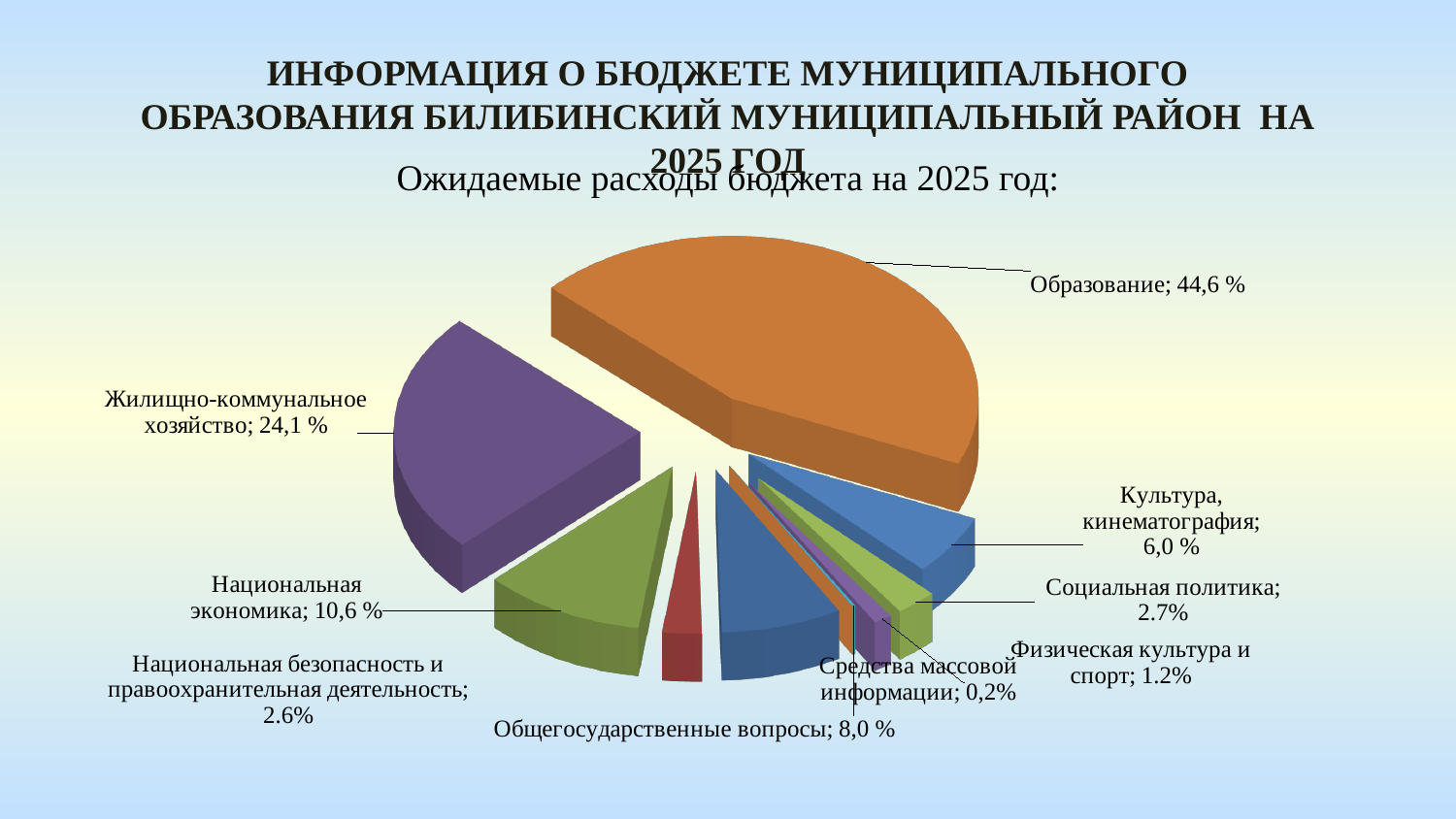
Как называется диаграмма на слайде? Ожидаемые расходы бюджета на 2025 год: Какая категория расходов имеет наименьшую долю? Средства массовой информации На сколько процентных пунктов доля «Образование» больше доли «Жилищно-коммунальное хозяйство»? 20,5 Какая доля расходов приходится на «Общегосударственные вопросы»? 8,0 % Сколько категорий расходов показано на диаграмме? 9 Какая категория расходов имеет наибольшую долю? Образование Какая доля расходов приходится на «Жилищно-коммунальное хозяйство»? 24,1 % Какой тип диаграммы показан на слайде? Круговая диаграмма Какая доля расходов приходится на «Образование»? 44,6 % Что больше: доля «Национальная экономика» или доля «Культура, кинематография»? Национальная экономика Какая доля расходов приходится на «Средства массовой информации»? 0,2% Какая доля расходов приходится на «Социальная политика»? 2.7%